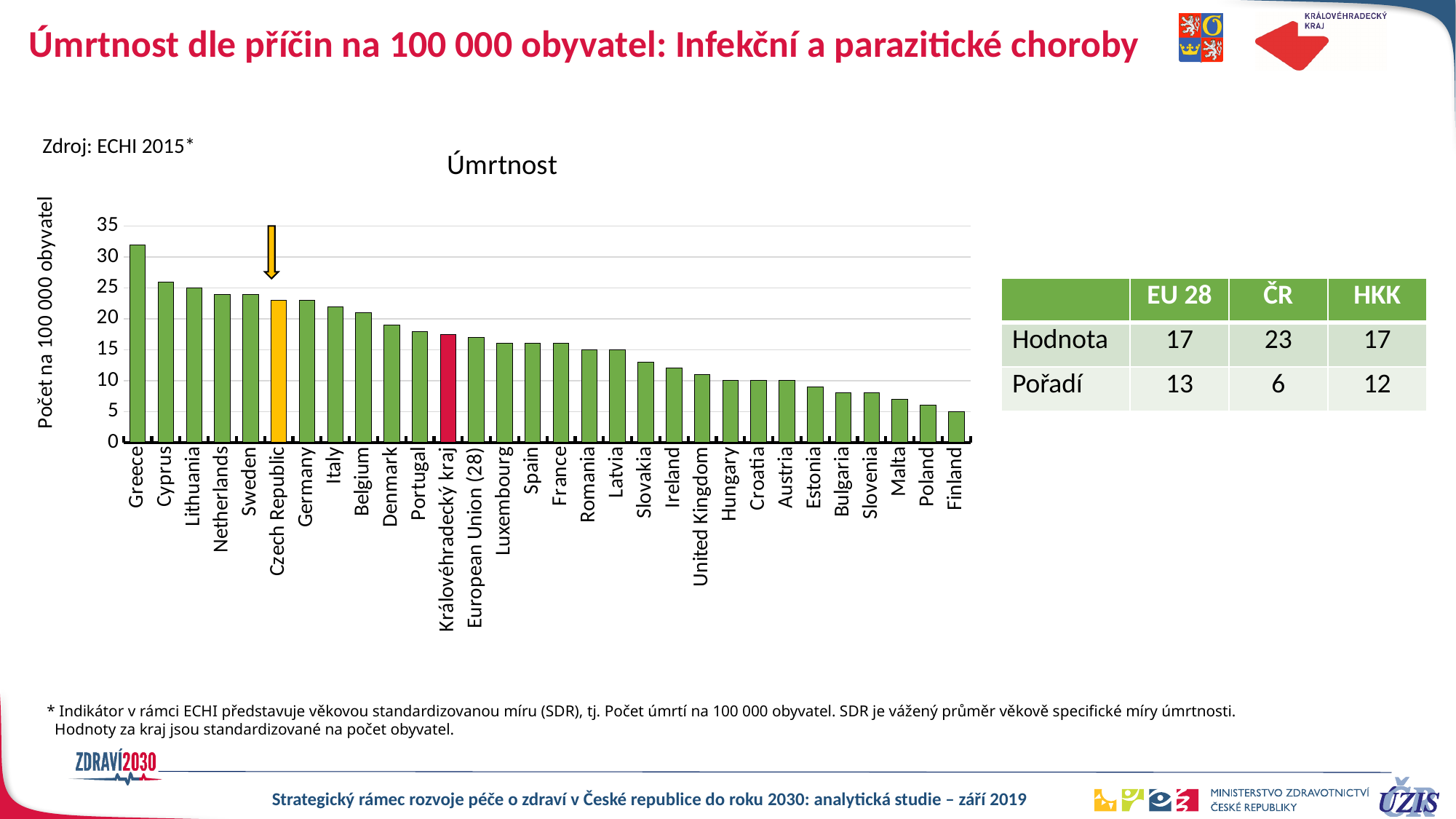
How many bars (categories) are plotted in the chart? 30 According to the table on the slide, what is the value (Hodnota) for ČR? 23 Do the values rise or fall moving from left to right along the x axis? fall According to the table on the slide, what is the difference between the value for ČR and the value for HKK? 6 What is the title of the chart? Úmrtnost Which has the larger value, Belgium or Denmark? Belgium Which country has the lowest mortality value in the chart? Finland Is the value for Slovakia greater or less than 10? greater Is the value for Greece greater or less than 30? greater Which country has the highest mortality value in the chart? Greece Is the value for Poland greater or less than 10? less What type of chart is shown on the slide? bar chart